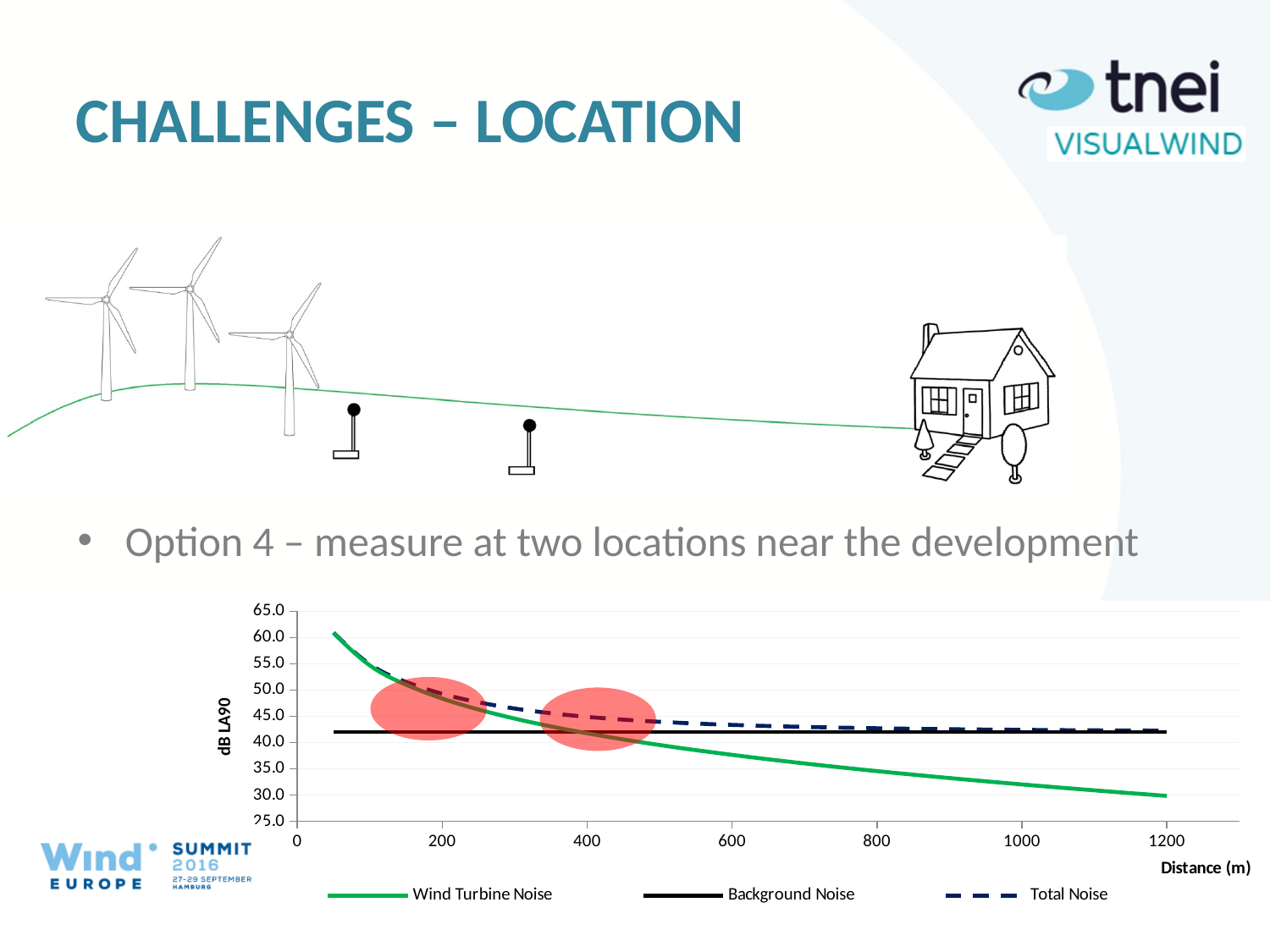
Is the Background Noise value greater or less than 45.0? less At 100 m, which is higher: Wind Turbine Noise or Background Noise? Wind Turbine Noise How many series does the chart legend list? 3 Is the Wind Turbine Noise value at 1000 m greater or less than 35.0? less What is the label on the vertical axis of the chart? dB LA90 Does the Wind Turbine Noise series rise or fall as distance increases? fall What kind of chart is shown on the slide? line chart Is the Wind Turbine Noise value at 200 m greater or less than 45.0? greater Does the Background Noise series rise, fall or stay flat as distance increases? stay flat Which series is drawn as a dashed line? Total Noise At 1200 m, which is higher: Total Noise or Wind Turbine Noise? Total Noise